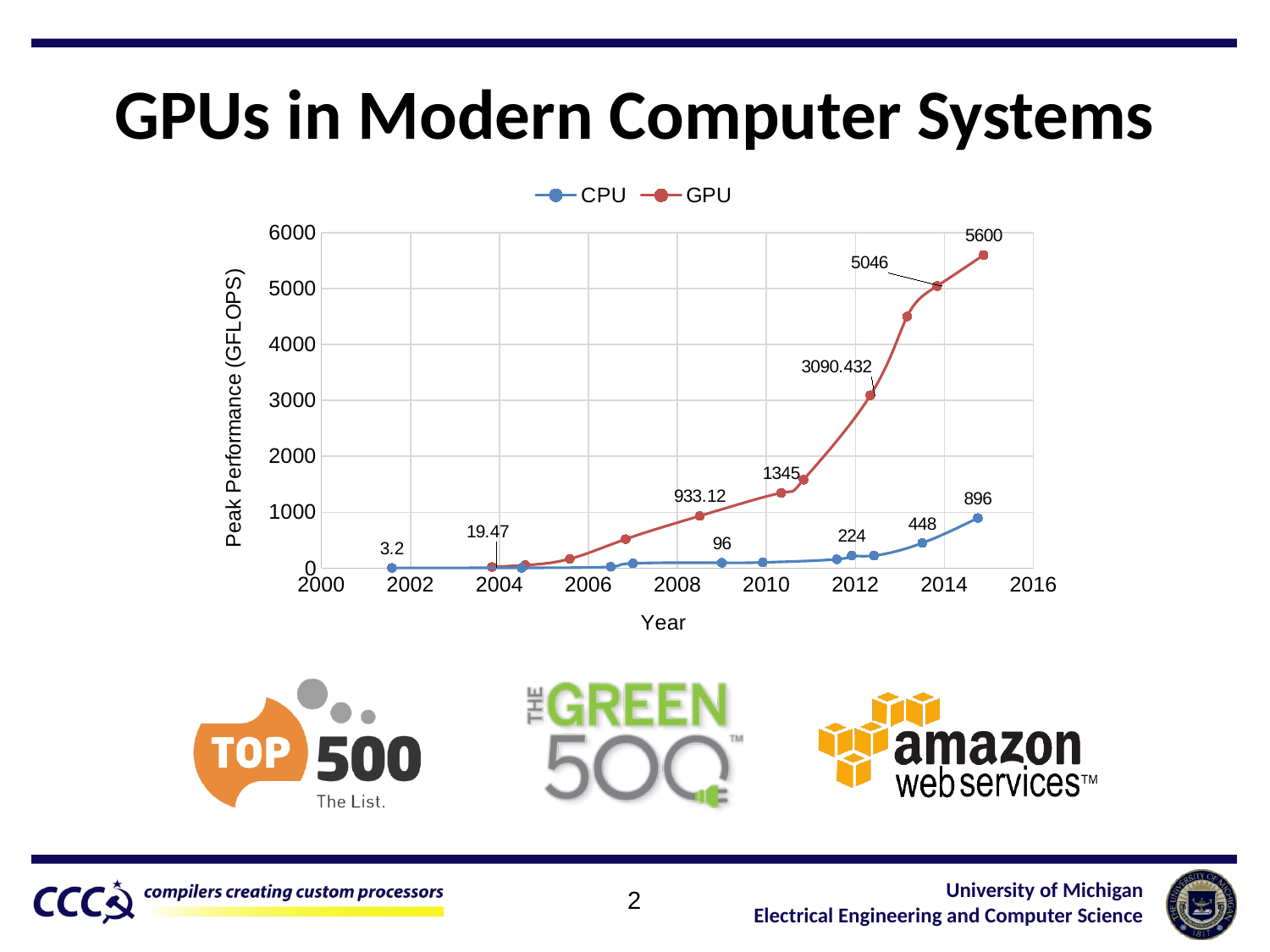
Which series has the larger value at the right end of the chart, CPU or GPU? GPU Do the GPU values rise or fall as the year increases? rise What is the difference between the GPU data labels 5600 and 5046? 554 What is the lowest labeled value on the CPU line? 3.2 How many series does the legend list? 2 Is the CPU value at 2010 greater or less than 1000? less What is the lowest labeled value on the GPU line? 19.47 What is the highest labeled value on the GPU line? 5600 What is the difference between the highest labeled GPU value (5600) and the highest labeled CPU value (896)? 4704 What is the label of the y axis? Peak Performance (GFLOPS) What kind of chart is shown on the slide? line chart What is the highest labeled value on the CPU line? 896